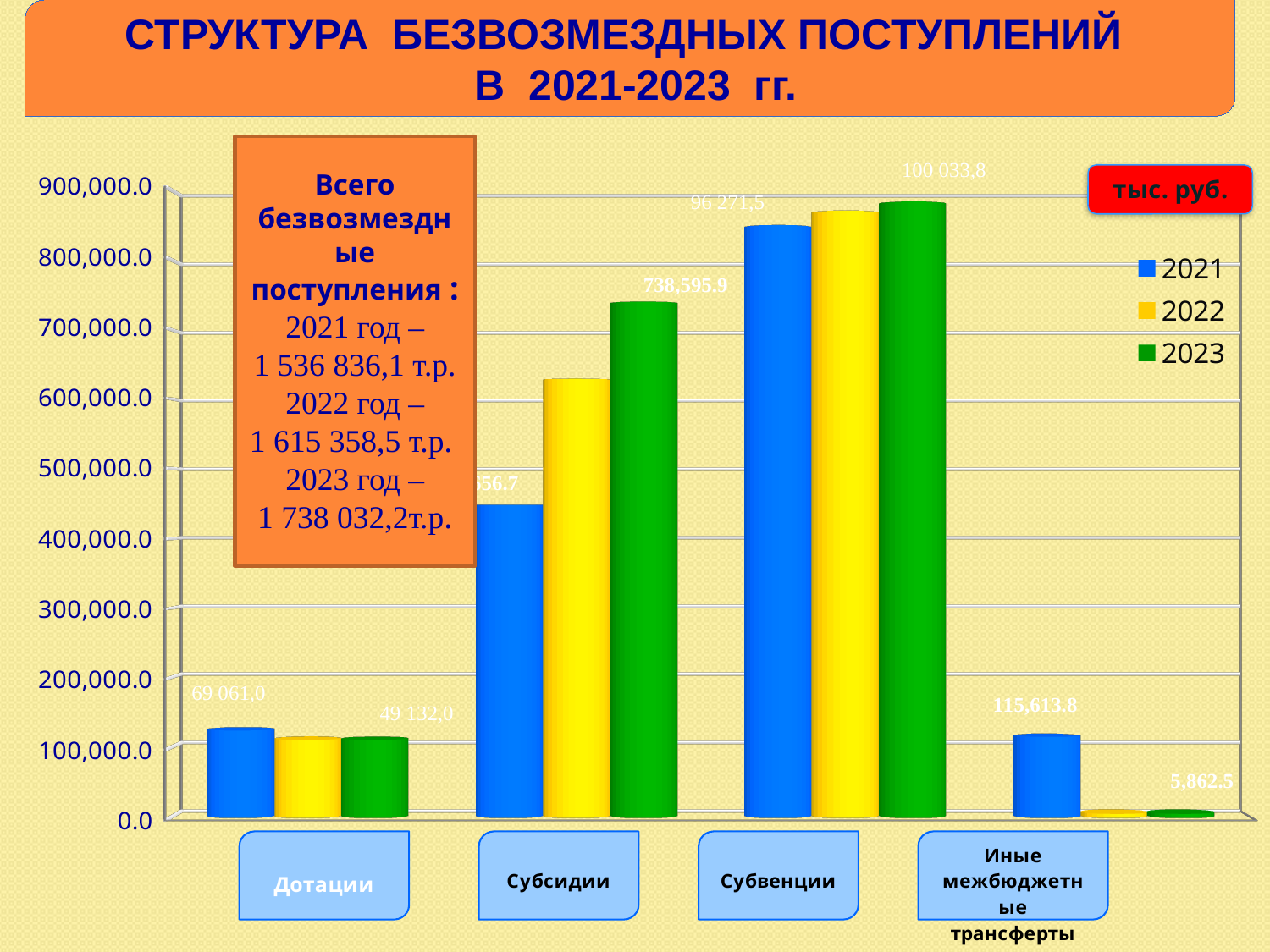
What kind of chart is shown on the slide? Bar chart What is the value for Иные межбюджетные трансферты in 2021? 115,613.8 Is the value for Субсидии in 2022 greater or less than 600,000.0? greater What is the value for Субсидии in 2023? 738,595.9 How many series does the legend list? 3 How many categories are shown on the x axis? 4 Do the values for Субсидии rise or fall from 2021 to 2023? Rise What is the value for Иные межбюджетные трансферты in 2023? 5,862.5 Which category has the highest bar in the chart? Субвенции What unit of measurement is indicated in the red box on the chart? тыс. руб. What is the difference between the 2021 and 2023 values for Иные межбюджетные трансферты? 109,751.3 Which category has the lowest bar in the chart? Иные межбюджетные трансферты